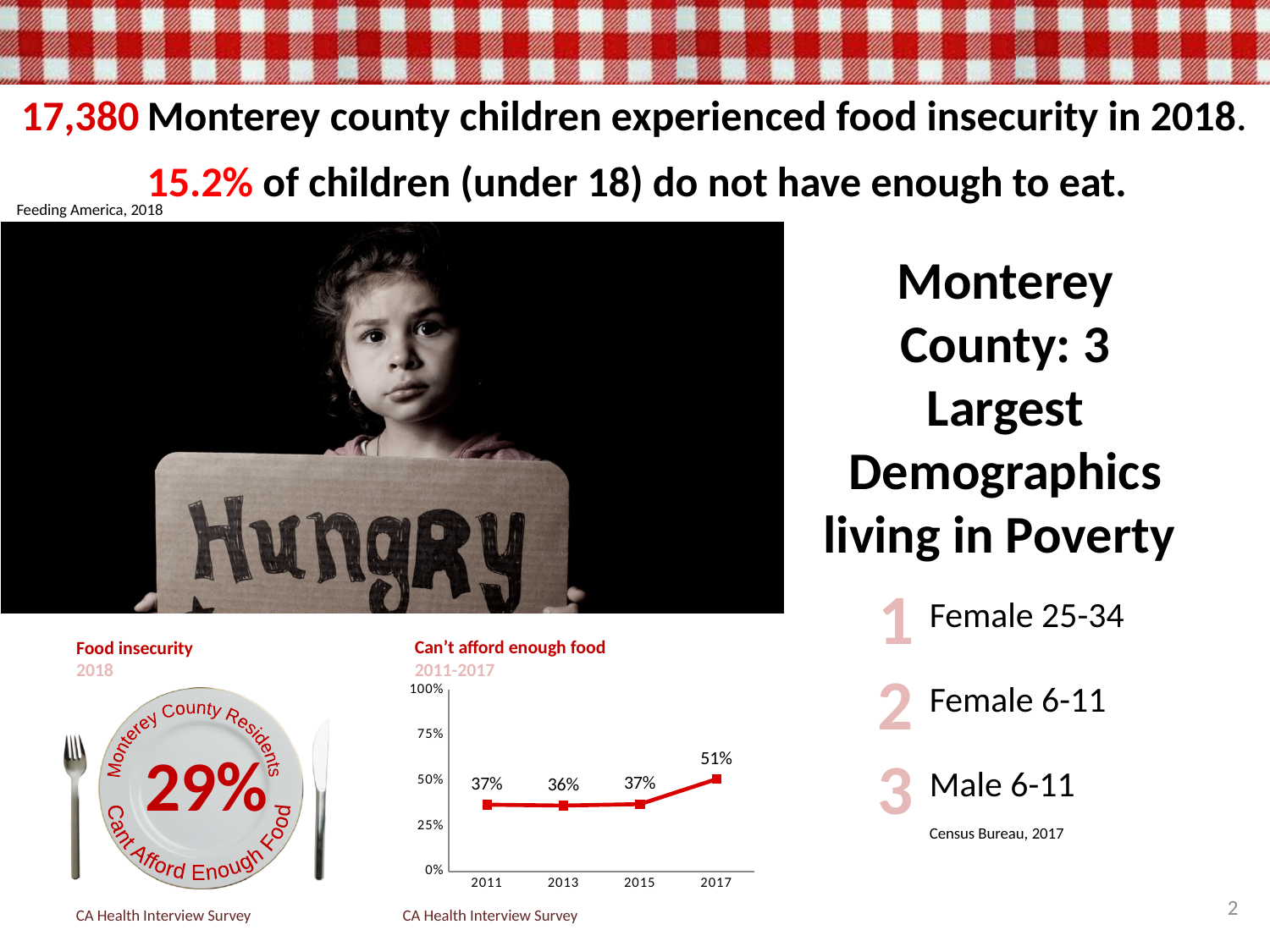
In the 'Can't afford enough food' chart, what is the difference between the 2017 and 2015 values? 14% In the 'Can't afford enough food' chart, is the value for 2011 greater or less than 25%? greater In the 'Can't afford enough food' chart, which year has the lowest value? 2013 In the 'Can't afford enough food' chart, which is larger, the value for 2011 or the value for 2017? 2017 In the 'Can't afford enough food' chart, which year has the highest value? 2017 What is the value for 2011 in the 'Can't afford enough food' chart? 37% How many data points are plotted in the 'Can't afford enough food' chart? 4 What is the value for 2017 in the 'Can't afford enough food' chart? 51% What is the value for 2015 in the 'Can't afford enough food' chart? 37% What kind of chart is the 'Can't afford enough food' chart? line chart In the 'Can't afford enough food' chart, do the values rise or fall from 2015 to 2017? rise What is the value for 2013 in the 'Can't afford enough food' chart? 36%